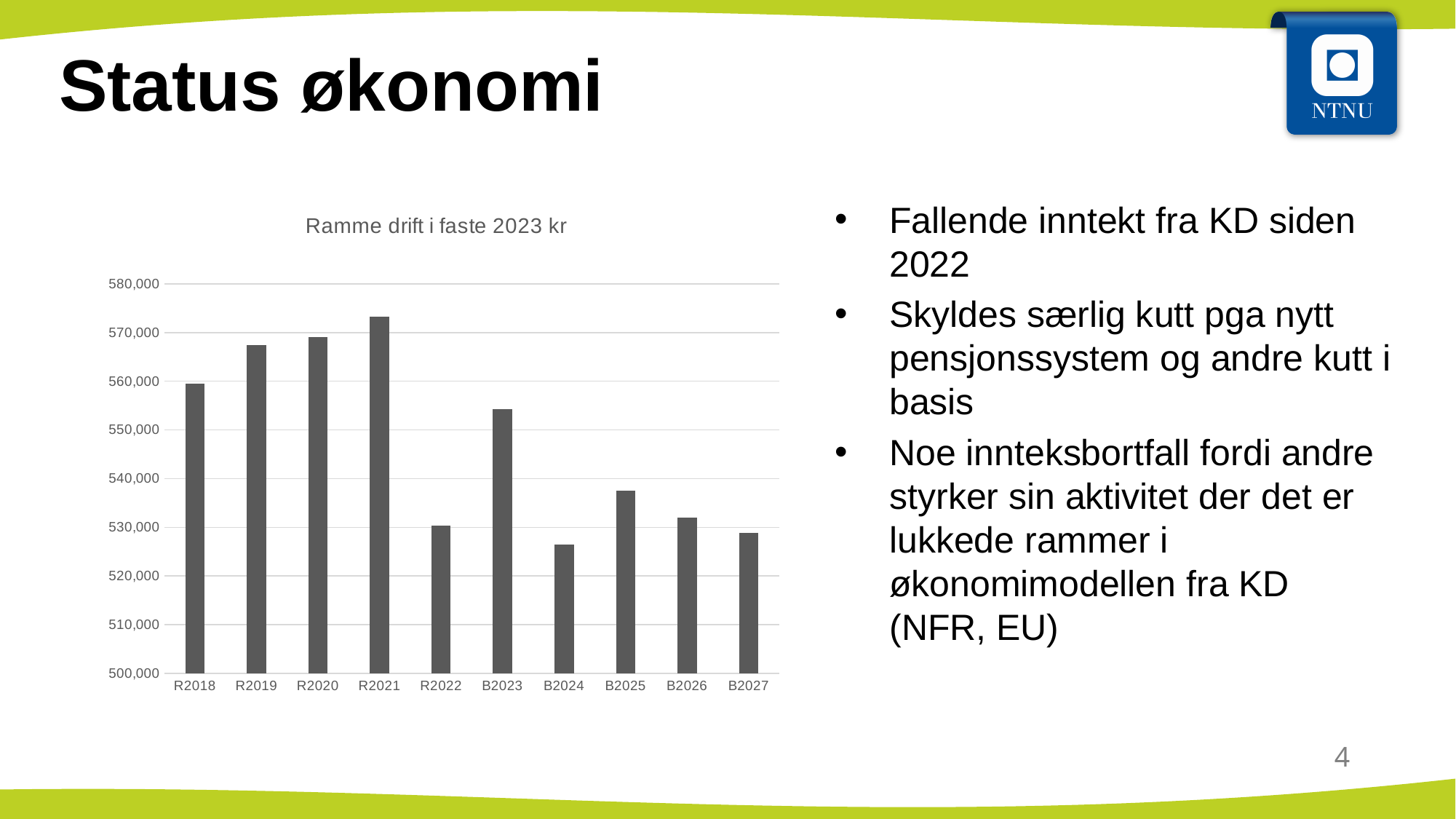
Is the value for R2022 greater or less than 540,000? less How many categories (years) are shown on the x axis of the chart? 10 Is the value for B2024 greater or less than 530,000? less Is the value for B2023 greater or less than 550,000? greater Which is larger, the value for R2019 or the value for B2023? R2019 Do the values rise or fall from R2018 to R2021? rise Which category has the lowest value in the chart? B2024 Which category has the highest value in the chart? R2021 What is the title of the chart? Ramme drift i faste 2023 kr Which is larger, the value for B2025 or the value for B2026? B2025 What type of chart is shown on the slide? Bar chart